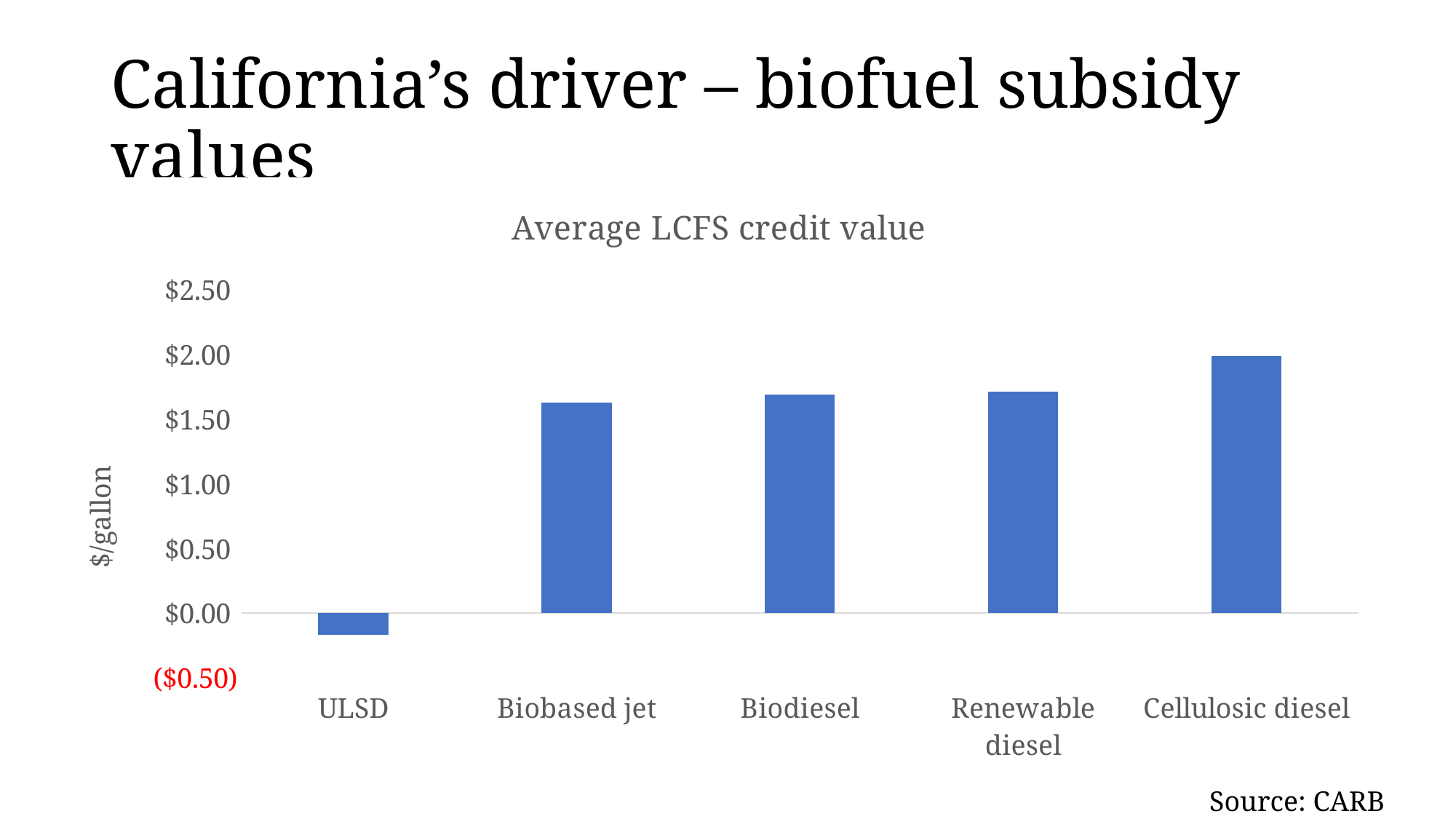
Which fuel has the highest average LCFS credit value? Cellulosic diesel What is the title of the chart? Average LCFS credit value Is the value for ULSD greater or less than $0.00? less Which has a larger average LCFS credit value, ULSD or Renewable diesel? Renewable diesel How many fuel categories are plotted in the chart? 5 What kind of chart is shown on the slide? bar chart Is the value for Renewable diesel greater or less than $1.50? greater Is the value for Biodiesel greater or less than $2.00? less Which has a larger average LCFS credit value, Cellulosic diesel or Biobased jet? Cellulosic diesel Which fuel has the lowest average LCFS credit value? ULSD